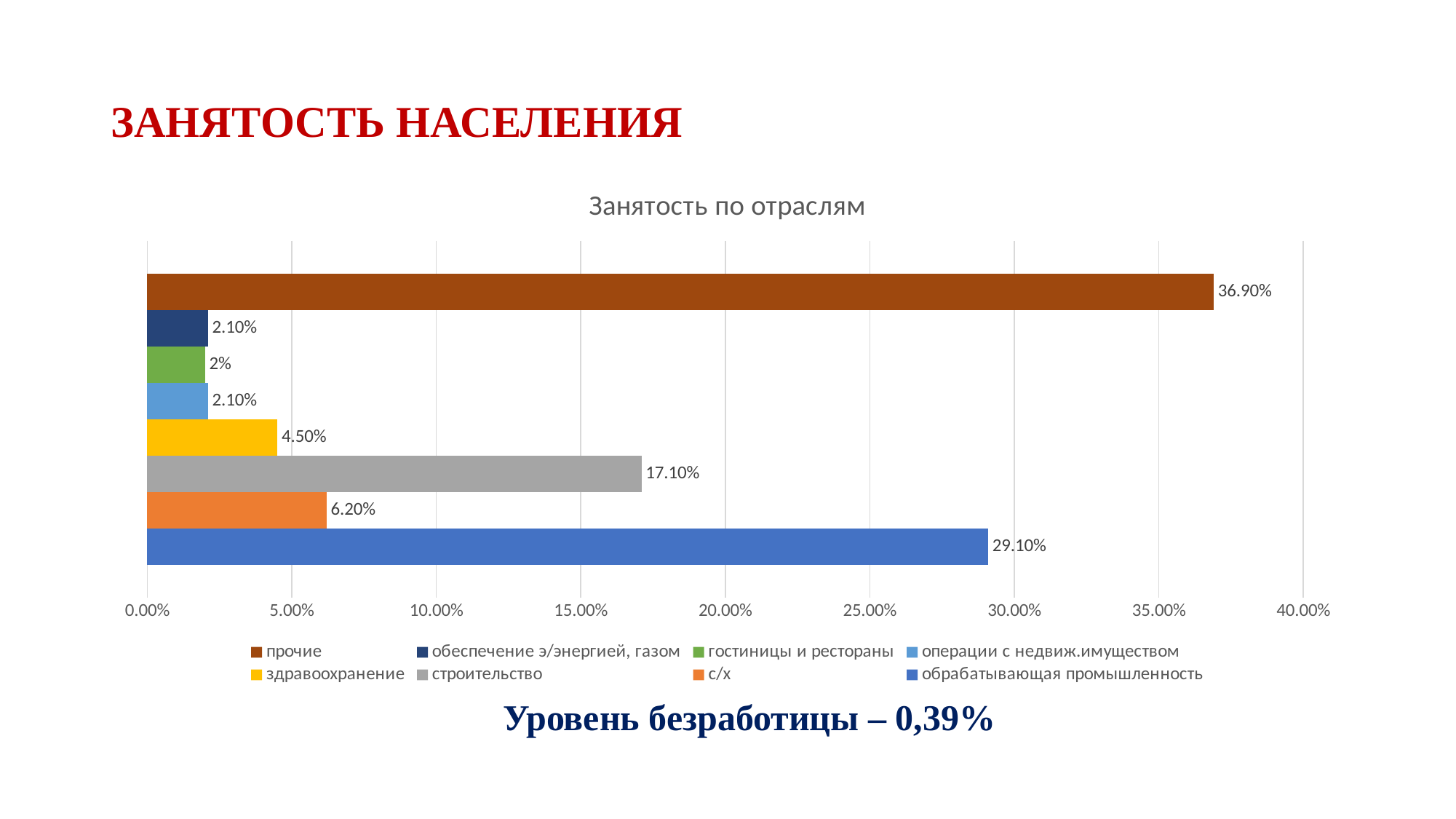
What is the value for прочие? 36.90% Which category has the lowest value? гостиницы и рестораны How many entries does the legend list? 8 Which category has the highest value? прочие What is the value for здравоохранение? 4.50% What is the value for строительство? 17.10% What type of chart is shown on the slide? bar chart What is the difference between the values for прочие and обрабатывающая промышленность? 7.80% What is the title of the chart? Занятость по отраслям What is the value for с/х? 6.20% Which is larger, the value for строительство or the value for с/х? строительство What is the value for обрабатывающая промышленность? 29.10%